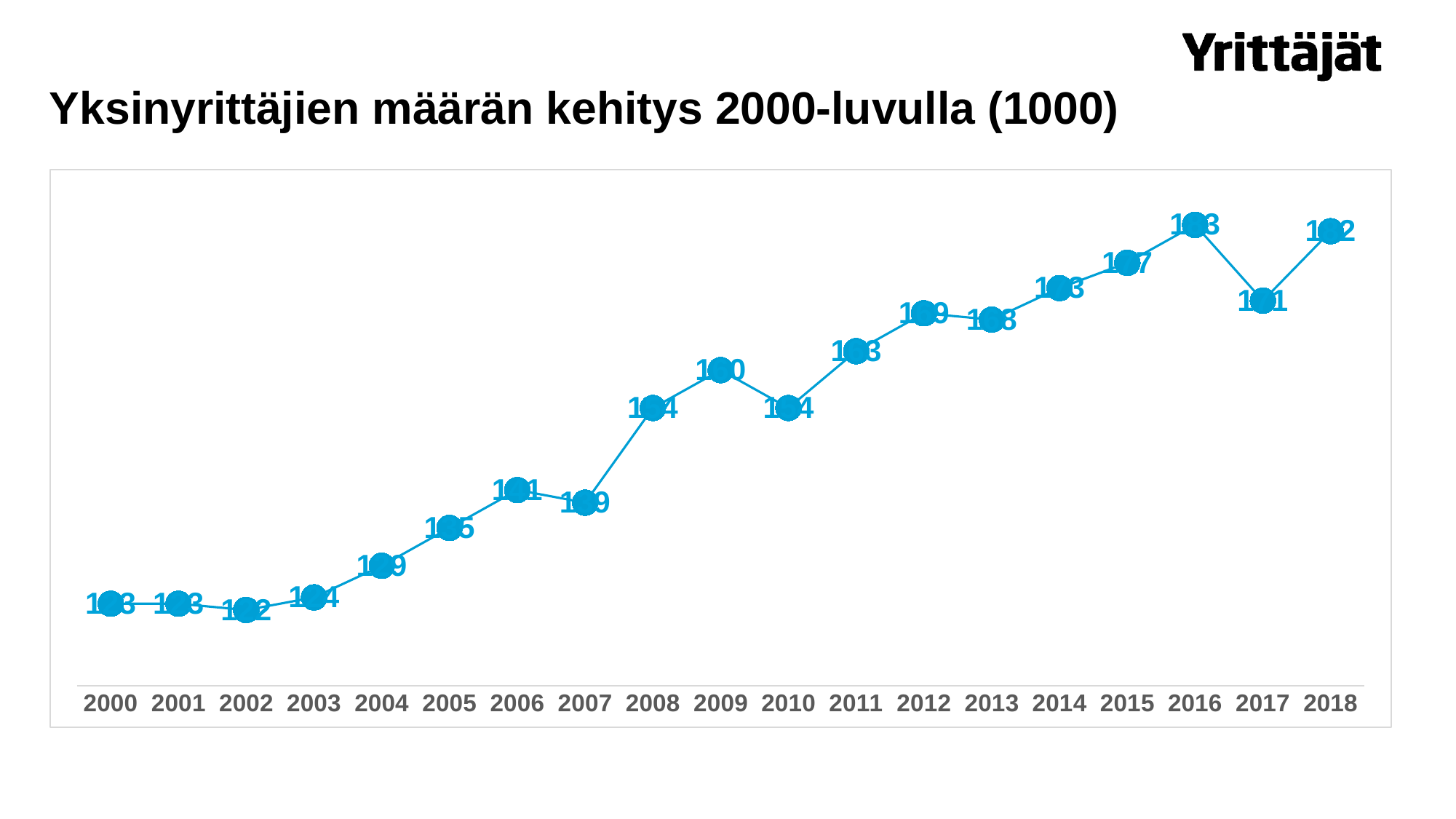
Overall, do the values rise or fall from 2000 to 2018? rise What is the first year shown on the x axis? 2000 What kind of chart is shown on the slide? line chart Does the value rise or fall from 2003 to 2006? rise Which year has the higher value, 2006 or 2007? 2006 What is the title of the chart? Yksinyrittäjien määrän kehitys 2000-luvulla (1000) Which year has the higher value, 2000 or 2018? 2018 Which year has the higher value, 2016 or 2017? 2016 How many years are plotted on the x axis? 19 Does the value rise or fall from 2016 to 2017? fall